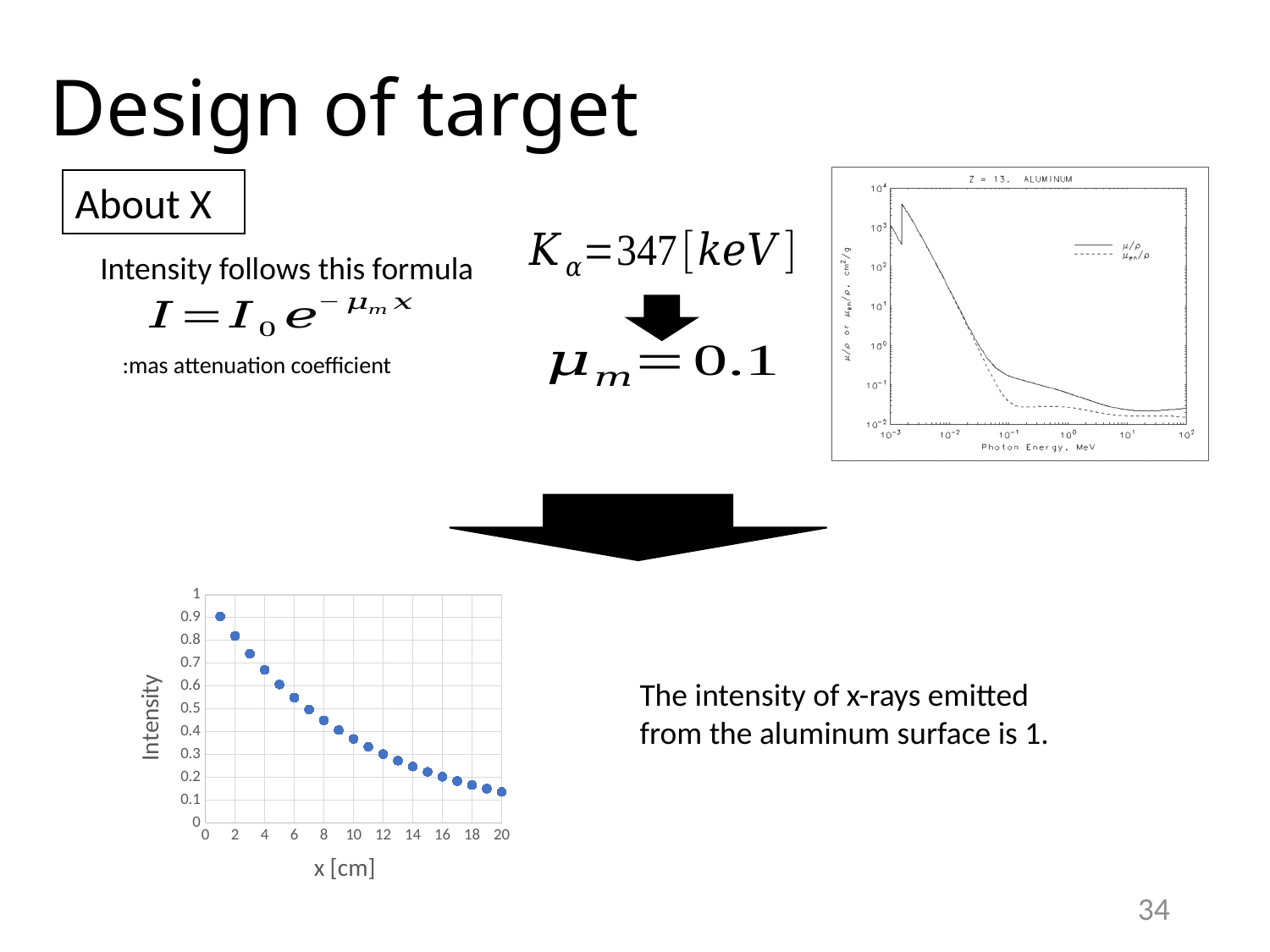
In the bottom-left chart, does the intensity rise or fall as x increases? fall What is the x-axis label of the bottom-left chart? x [cm] In the bottom-left chart, is the intensity at x = 1 greater or less than 0.8? greater How many series does the legend of the top-right aluminum chart list? 2 In the bottom-left chart, which has the larger intensity, x = 4 or x = 12? x = 4 In the bottom-left chart, at which x value is the intensity lowest? 20 In the bottom-left chart, is the intensity at x = 10 greater or less than 0.5? less What kind of chart is the one at the bottom left of the slide? scatter chart In the bottom-left chart, is the intensity at x = 20 greater or less than 0.2? less In the bottom-left chart, at which x value is the intensity highest? 1 How many data points are plotted in the bottom-left chart? 20